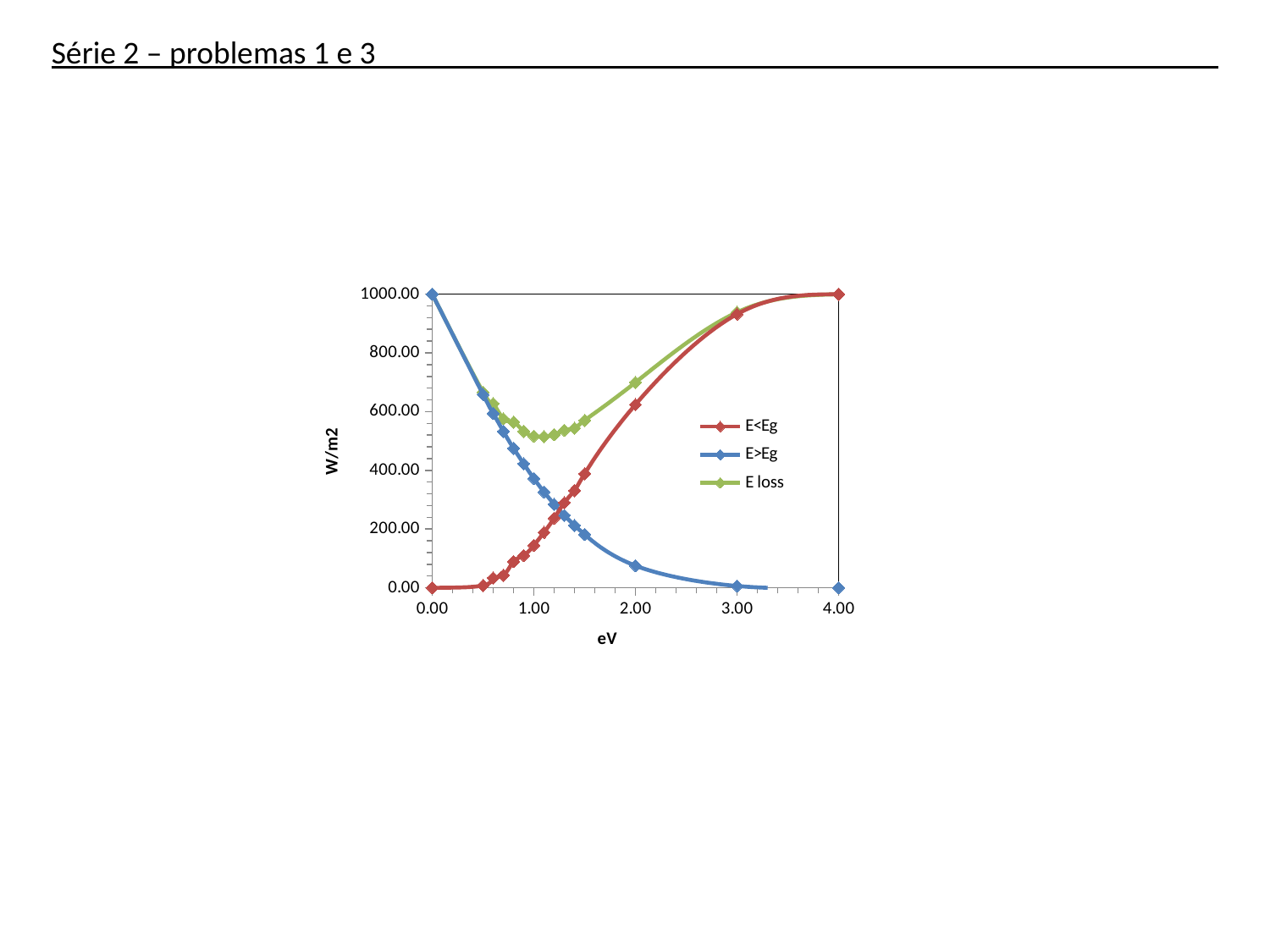
What is the value of the E>Eg series at 0.00 eV? 1000.00 What kind of chart is shown on the slide? line chart At 1.00 eV, which series has the larger value, E>Eg or E<Eg? E>Eg Is the value of the E>Eg series at 2.00 eV greater or less than 200.00? less Is the value of the E loss series at 3.00 eV greater or less than 800.00? greater Does the E>Eg series rise or fall as eV increases? falls Does the E<Eg series rise or fall as eV increases? rises What is the label of the vertical axis? W/m2 What is the value of the E<Eg series at 0.00 eV? 0.00 How many series does the legend list? 3 Is the value of the E<Eg series at 2.00 eV greater or less than 600.00? greater